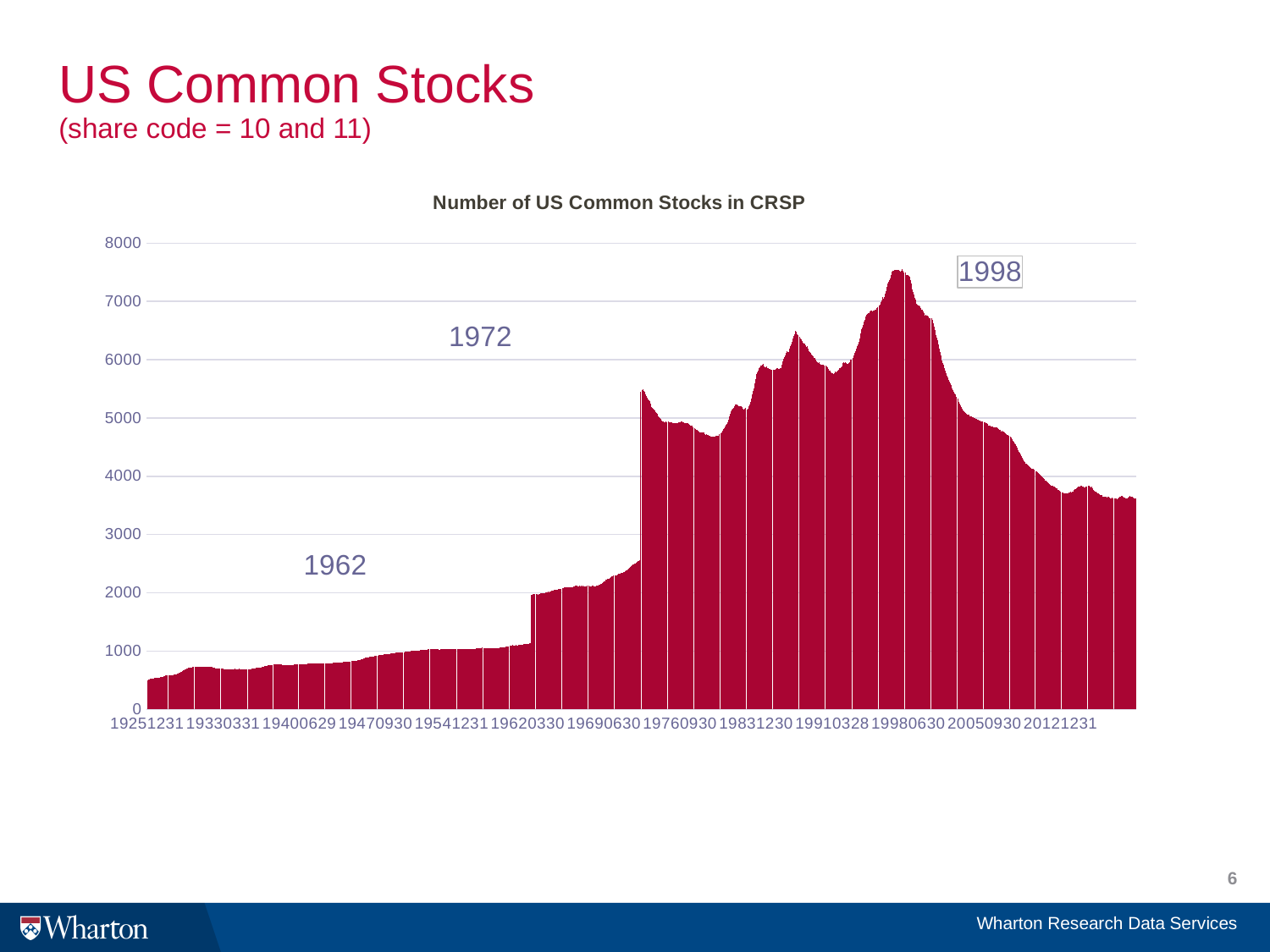
What kind of chart is shown on the slide? bar chart Is the value at 19980630 greater or less than 7000? greater Is the value at 19831230 greater or less than 5000? greater Which year is labelled at the peak of the chart? 1998 Is the value at 19251231 greater or less than 1000? less Do the values rise or fall between 19980630 and 20121231? fall What is the highest value shown on the vertical axis? 8000 What is the title of the chart? Number of US Common Stocks in CRSP